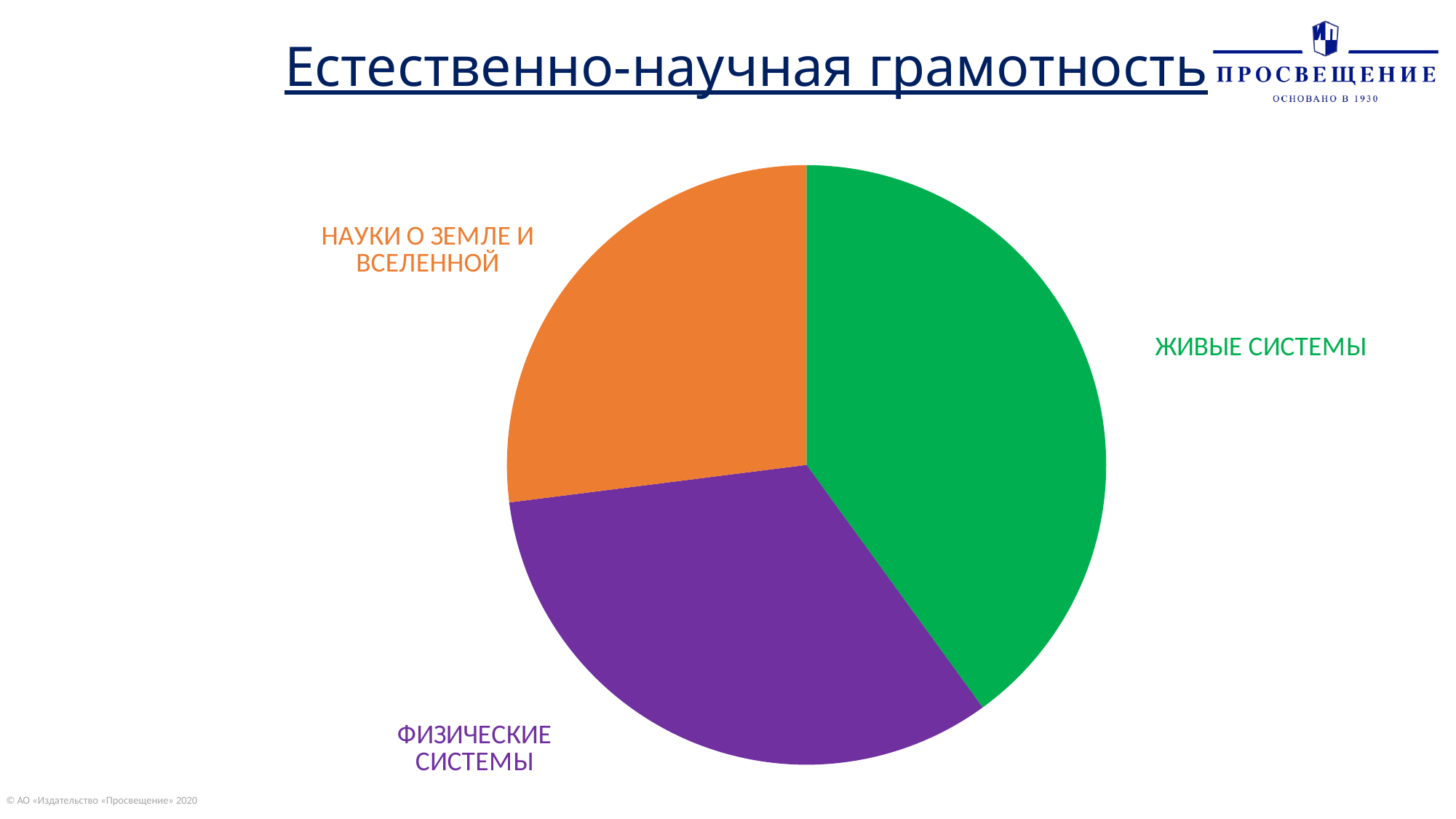
Which slice is larger: ЖИВЫЕ СИСТЕМЫ or НАУКИ О ЗЕМЛЕ И ВСЕЛЕННОЙ? ЖИВЫЕ СИСТЕМЫ What colour is the ФИЗИЧЕСКИЕ СИСТЕМЫ slice of the pie chart? purple How many slices does the pie chart have? 3 Which category has the smallest slice of the pie chart? НАУКИ О ЗЕМЛЕ И ВСЕЛЕННОЙ What is the title of the slide containing the pie chart? Естественно-научная грамотность Which slice is larger: ФИЗИЧЕСКИЕ СИСТЕМЫ or НАУКИ О ЗЕМЛЕ И ВСЕЛЕННОЙ? ФИЗИЧЕСКИЕ СИСТЕМЫ Which category has the largest slice of the pie chart? ЖИВЫЕ СИСТЕМЫ What kind of chart is shown on the slide? pie chart